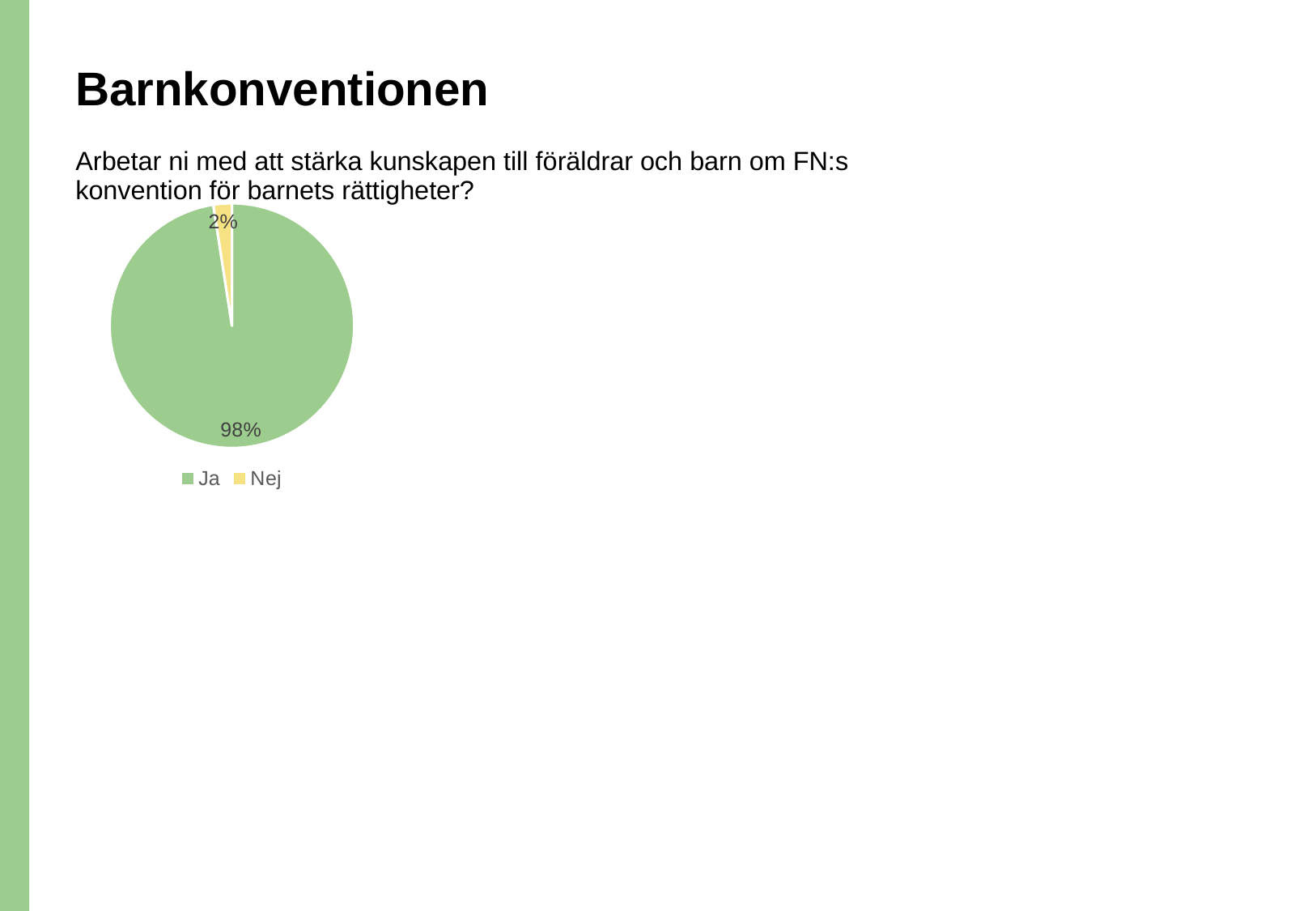
Which category has the largest slice of the pie? Ja How many categories does the pie chart show? 2 What colour is the "Nej" slice? Yellow What colour is the "Ja" slice? Green What is the difference in percentage points between the "Ja" and "Nej" slices? 96 How many entries does the legend list? 2 Which is larger, the "Ja" slice or the "Nej" slice? Ja Which category has the smallest slice of the pie? Nej What share of the pie does "Ja" represent? 98% What kind of chart is shown on the slide? Pie chart What share of the pie does "Nej" represent? 2%